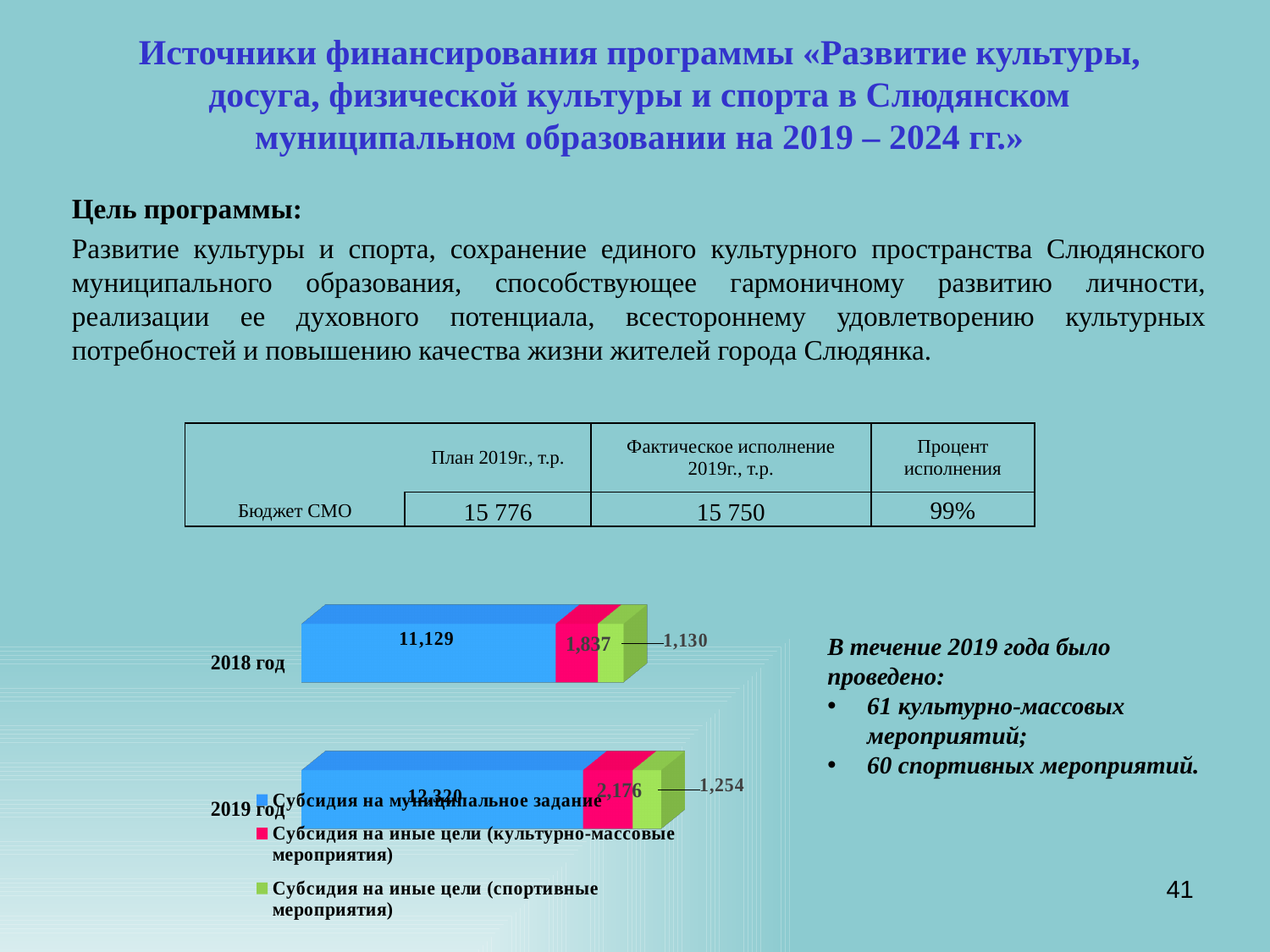
What is the value of «Субсидия на иные цели (спортивные мероприятия)» for 2019 год? 1,254 What is the value of «Субсидия на иные цели (культурно-массовые мероприятия)» for 2018 год? 1,837 What kind of chart is shown on the slide? bar chart What is the value of «Субсидия на иные цели (спортивные мероприятия)» for 2018 год? 1,130 How many series does the chart legend list? 3 What is the value of «Субсидия на муниципальное задание» for 2018 год? 11,129 By how much did «Субсидия на иные цели (культурно-массовые мероприятия)» increase from 2018 год to 2019 год? 339 How many categories (years) does the chart show? 2 Which series has the largest value in the 2018 год bar? Субсидия на муниципальное задание Which year has the larger value for «Субсидия на иные цели (спортивные мероприятия)», 2018 год or 2019 год? 2019 год What is the value of «Субсидия на иные цели (культурно-массовые мероприятия)» for 2019 год? 2,176 What is the total of the stacked bar for 2018 год? 14,096